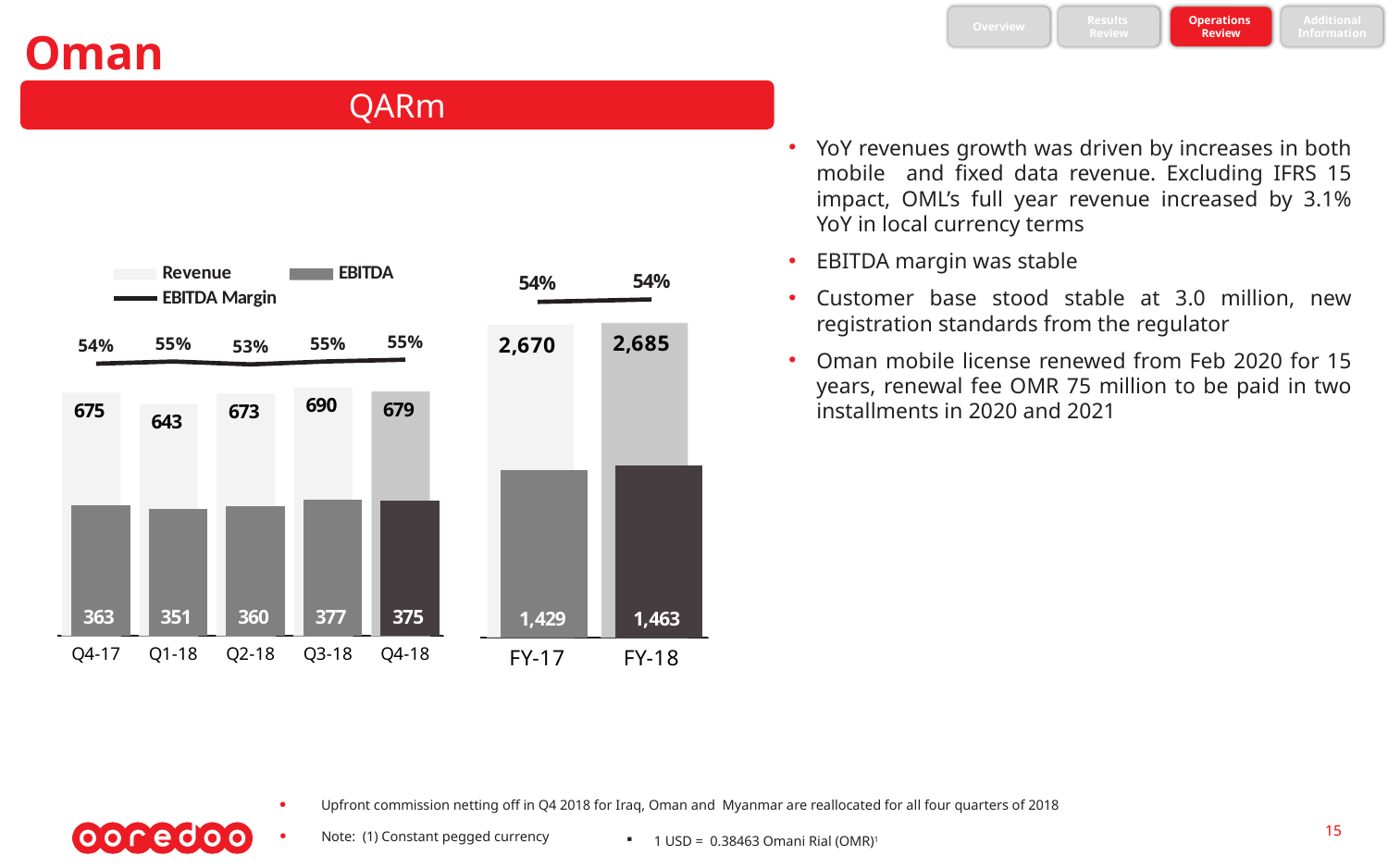
In the full-year chart, what is the Revenue value for FY-18? 2,685 In the quarterly chart, what is the EBITDA Margin for Q2-18? 53% In the quarterly chart, which quarter has the lowest EBITDA? Q1-18 In the full-year chart, what is the difference in EBITDA between FY-18 and FY-17? 34 In the full-year chart, what is the EBITDA value for FY-17? 1,429 In the quarterly chart, which is larger, the Revenue for Q4-17 or the Revenue for Q1-18? Q4-17 In the quarterly chart, what is the Revenue value for Q3-18? 690 How many quarters are shown in the quarterly chart? 5 How many series does the legend list? 3 In the quarterly chart, which quarter has the highest Revenue? Q3-18 In the quarterly chart, what is the EBITDA value for Q1-18? 351 What kind of chart is used to show Revenue and EBITDA on this slide? Bar chart